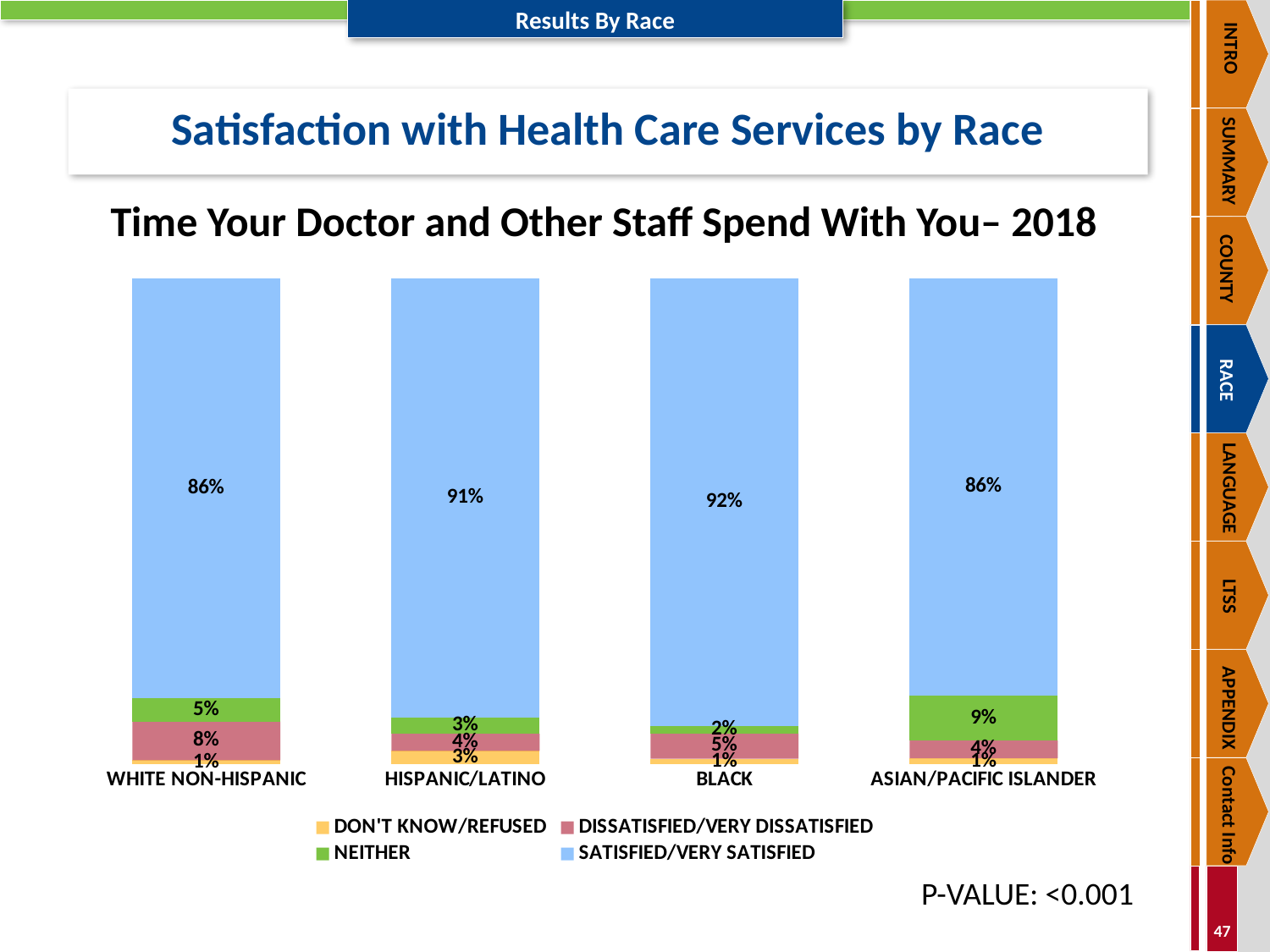
How many series does the legend list? 4 Which race group has the highest Satisfied/Very Satisfied percentage? Black What is the Don't Know/Refused value for Hispanic/Latino respondents? 3% How many race categories are shown on the x axis? 4 What is the Neither value for Asian/Pacific Islander respondents? 9% What percentage of White Non-Hispanic respondents were Dissatisfied/Very Dissatisfied? 8% Which is larger: the Dissatisfied/Very Dissatisfied value for White Non-Hispanic or for Hispanic/Latino? White Non-Hispanic What kind of chart is shown on the slide? Stacked bar chart What percentage of Black respondents were Satisfied/Very Satisfied with the time their doctor and other staff spend with them? 92% What is the total of the stacked bar for Black respondents? 100% Which race group has the lowest Neither percentage? Black What is the difference between the Satisfied/Very Satisfied percentages for Black and White Non-Hispanic respondents? 6%